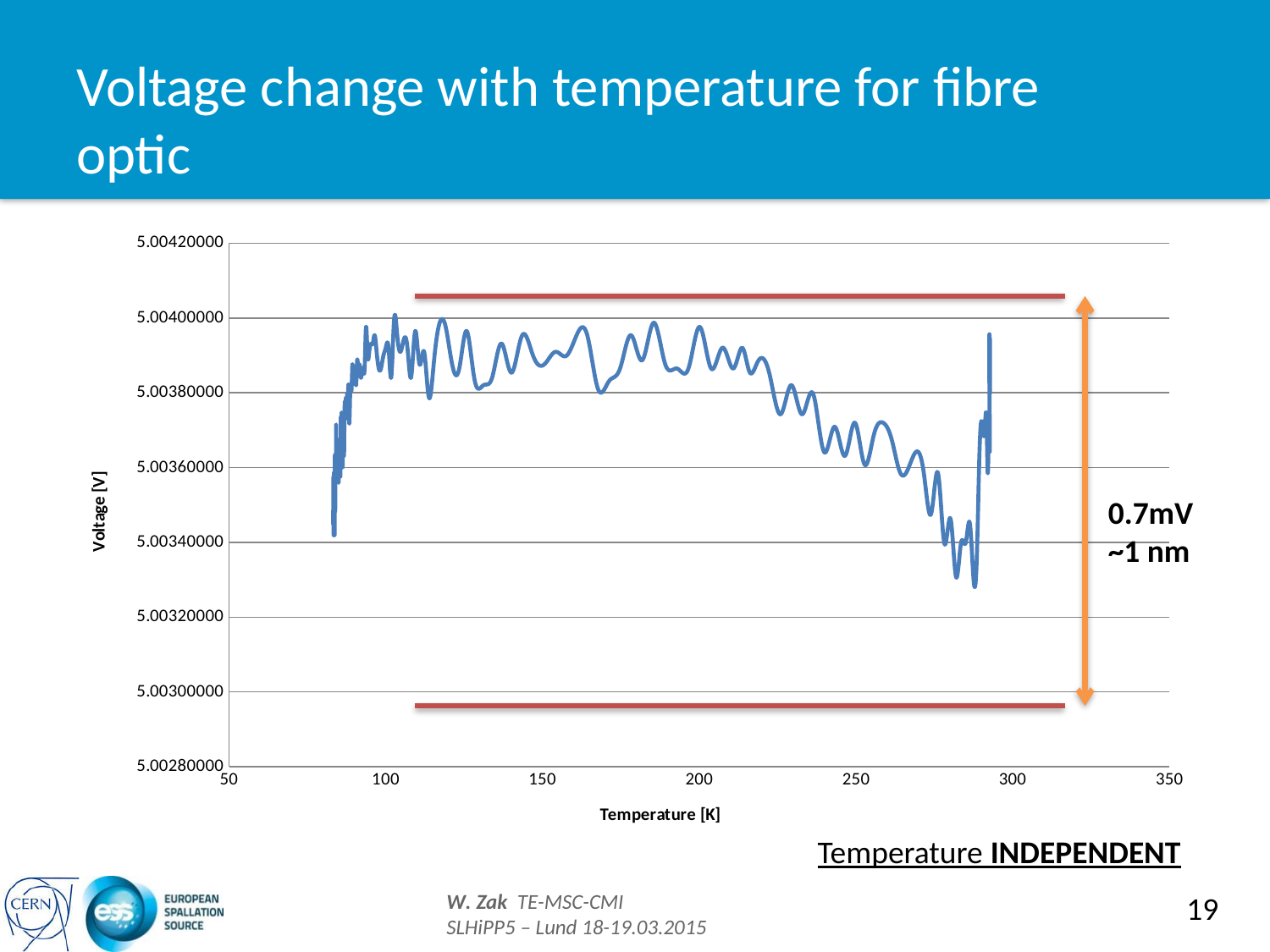
Does the voltage rise or fall as temperature increases from about 85 K to 100 K? rise What kind of chart is shown on the slide? line chart Is the voltage at 250 K greater or less than 5.00380000 V? less What is the label of the vertical axis of the chart? Voltage [V] Is the voltage at 100 K greater or less than 5.00360000 V? greater What is the label of the horizontal axis of the chart? Temperature [K] Is the voltage at 280 K greater or less than 5.00360000 V? less Does the voltage generally rise or fall as temperature increases from 200 K to 280 K? fall Is the voltage at 100 K larger or smaller than the voltage at 280 K? larger Is the lowest voltage on the curve reached at a temperature above or below 250 K? above What is the highest value shown on the vertical axis of the chart? 5.00420000